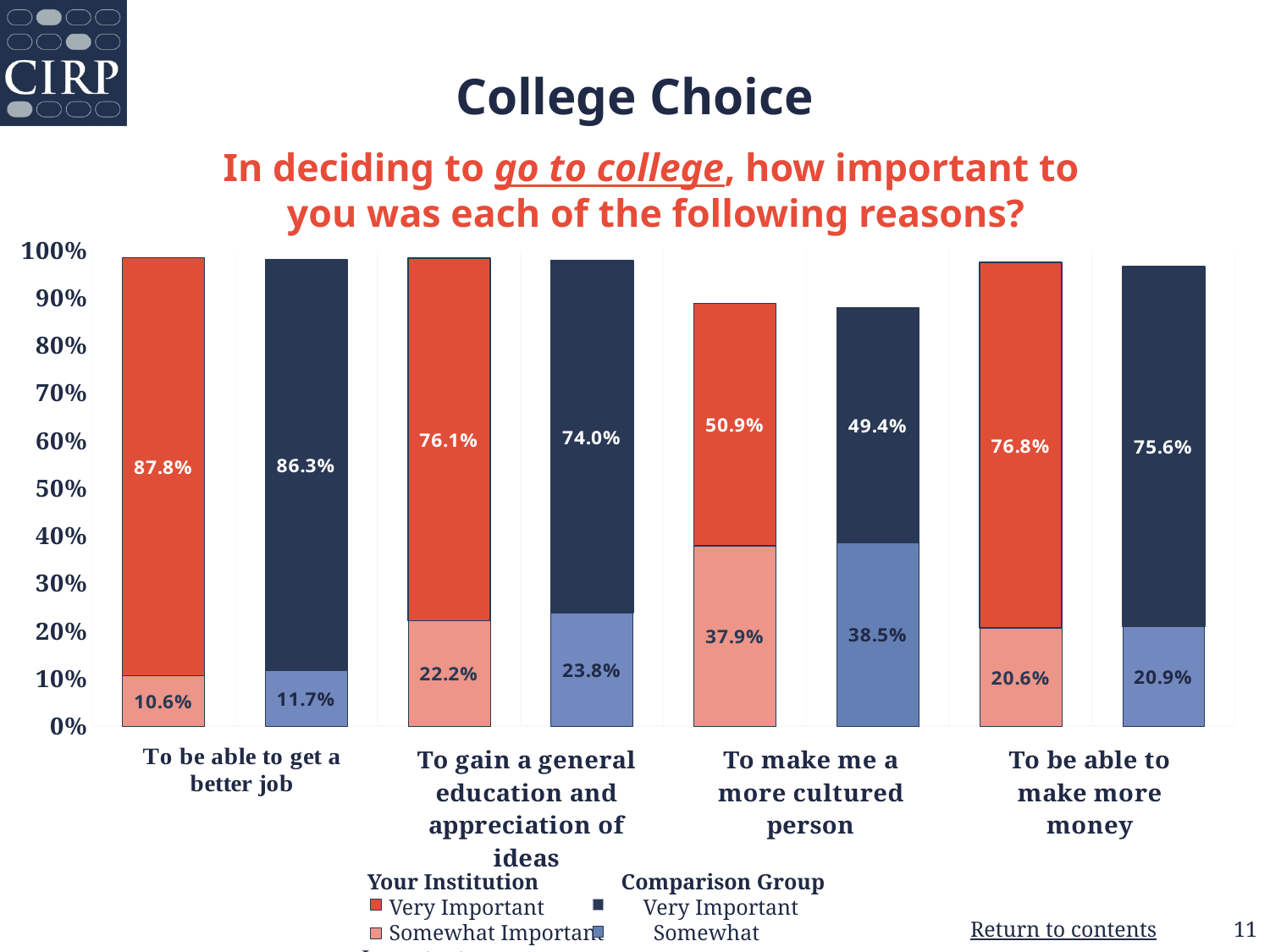
What is the combined Very Important and Somewhat Important total for the Comparison Group for "To be able to make more money"? 96.5% How many series does the chart legend list? 4 For "To be able to get a better job", which group has the larger Somewhat Important percentage, Your Institution or the Comparison Group? Comparison Group What type of chart is shown on the slide? Stacked bar chart What is the Very Important percentage for the Comparison Group for "To be able to make more money"? 75.6% What percentage of the Comparison Group rated "To make me a more cultured person" as Somewhat Important? 38.5% Which reason has the lowest Very Important percentage for the Comparison Group? To make me a more cultured person How many reasons (categories) are shown on the x axis of the chart? 4 Which reason has the highest Very Important percentage for Your Institution? To be able to get a better job What percentage of Your Institution students rated "To be able to get a better job" as Very Important? 87.8% What is the combined Very Important and Somewhat Important total for Your Institution for "To make me a more cultured person"? 88.8% What is the difference between the Your Institution and Comparison Group Very Important percentages for "To gain a general education and appreciation of ideas"? 2.1%